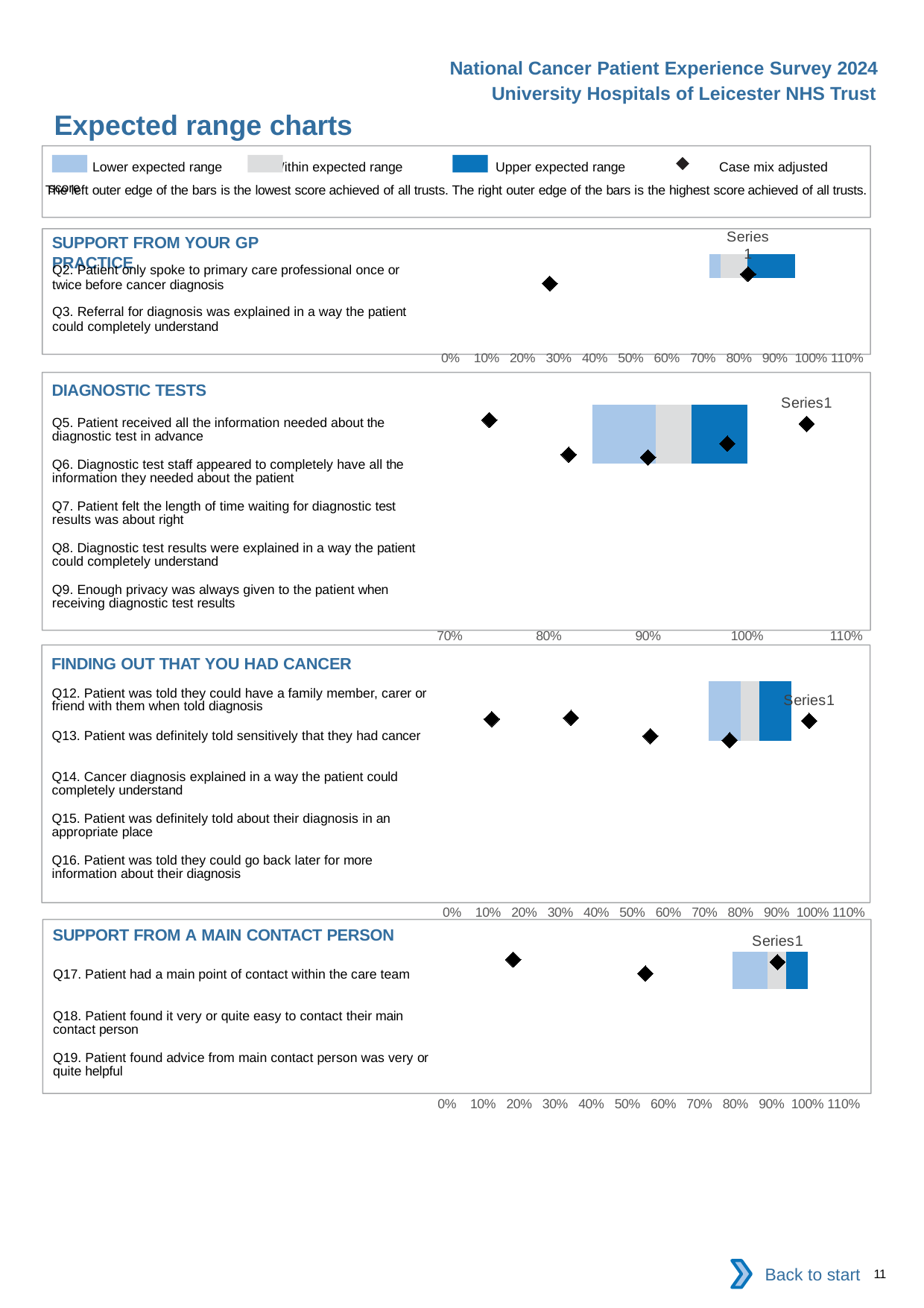
In the 'SUPPORT FROM YOUR GP PRACTICE' chart, how many questions are listed? 2 In the 'SUPPORT FROM A MAIN CONTACT PERSON' chart, how many questions are listed? 3 In the 'FINDING OUT THAT YOU HAD CANCER' chart, how many questions are listed? 5 What kind of chart is used in the 'DIAGNOSTIC TESTS' section? bar chart In the 'FINDING OUT THAT YOU HAD CANCER' chart, is the right edge of the expected range bar greater or less than 50%? greater In the 'DIAGNOSTIC TESTS' chart, is the left edge of the expected range bar greater or less than 80%? greater What is the lowest axis tick label shown on the 'DIAGNOSTIC TESTS' chart? 70% How many entries does the legend at the top of the slide list? 4 According to the legend, what does the diamond marker represent? Case mix adjusted score